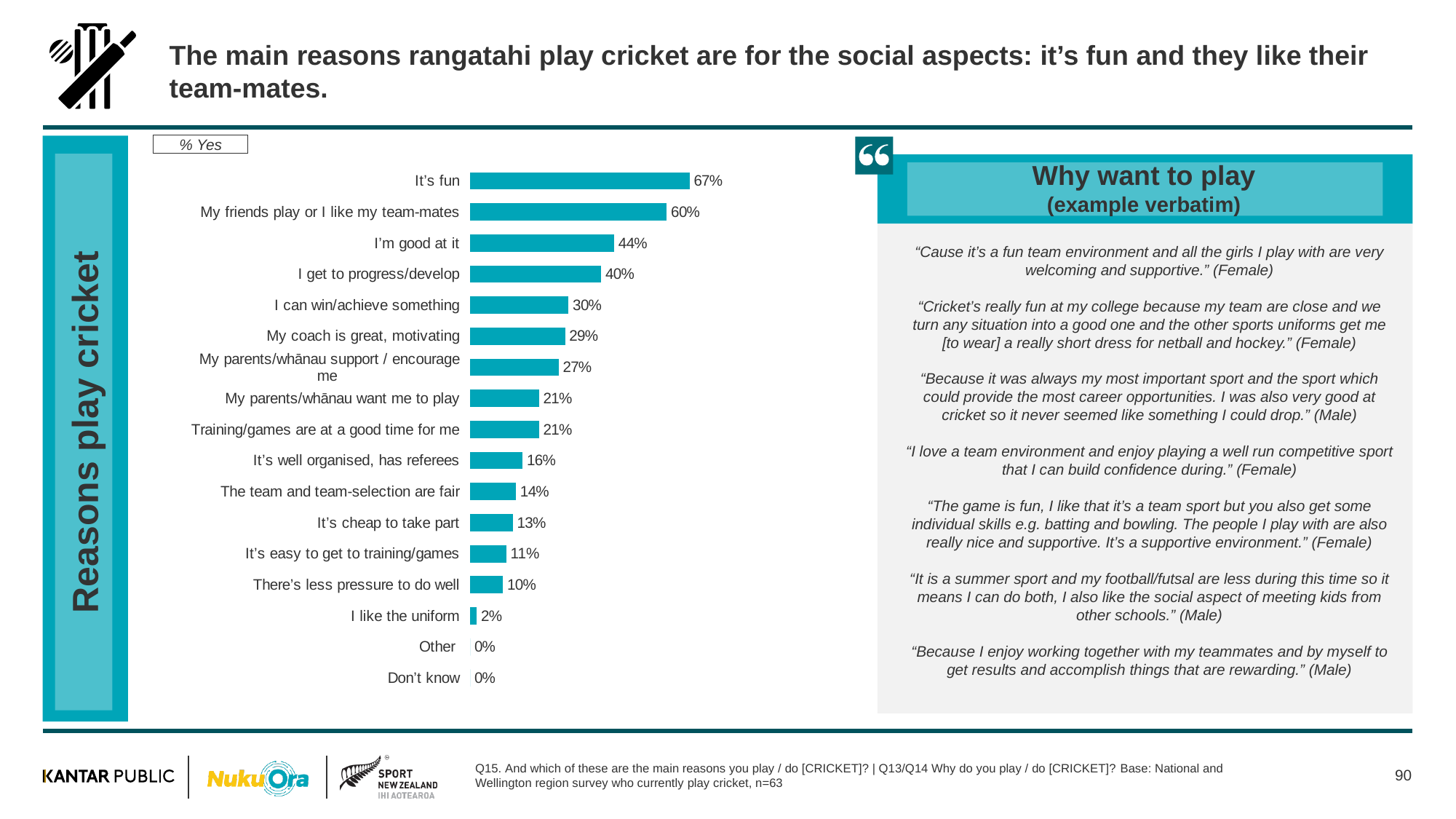
What is the value for "There's less pressure to do well"? 10% What percentage of rangatahi said they play cricket because it's fun? 67% Which reason for playing cricket has the highest percentage? It's fun What percentage said "I'm good at it" as a reason for playing cricket? 44% What kind of chart is used to show the reasons rangatahi play cricket? Bar chart What is the difference between "It's fun" and "My friends play or I like my team-mates"? 7% Which is larger: "My coach is great, motivating" or "It's well organised, has referees"? My coach is great, motivating What is the title of the text box to the right of the chart? Why want to play (example verbatim) What is the value for "My friends play or I like my team-mates"? 60% What is the difference between "I get to progress/develop" and "I can win/achieve something"? 10% How many reasons (categories) are listed in the bar chart? 17 What is the value for "I like the uniform"? 2%